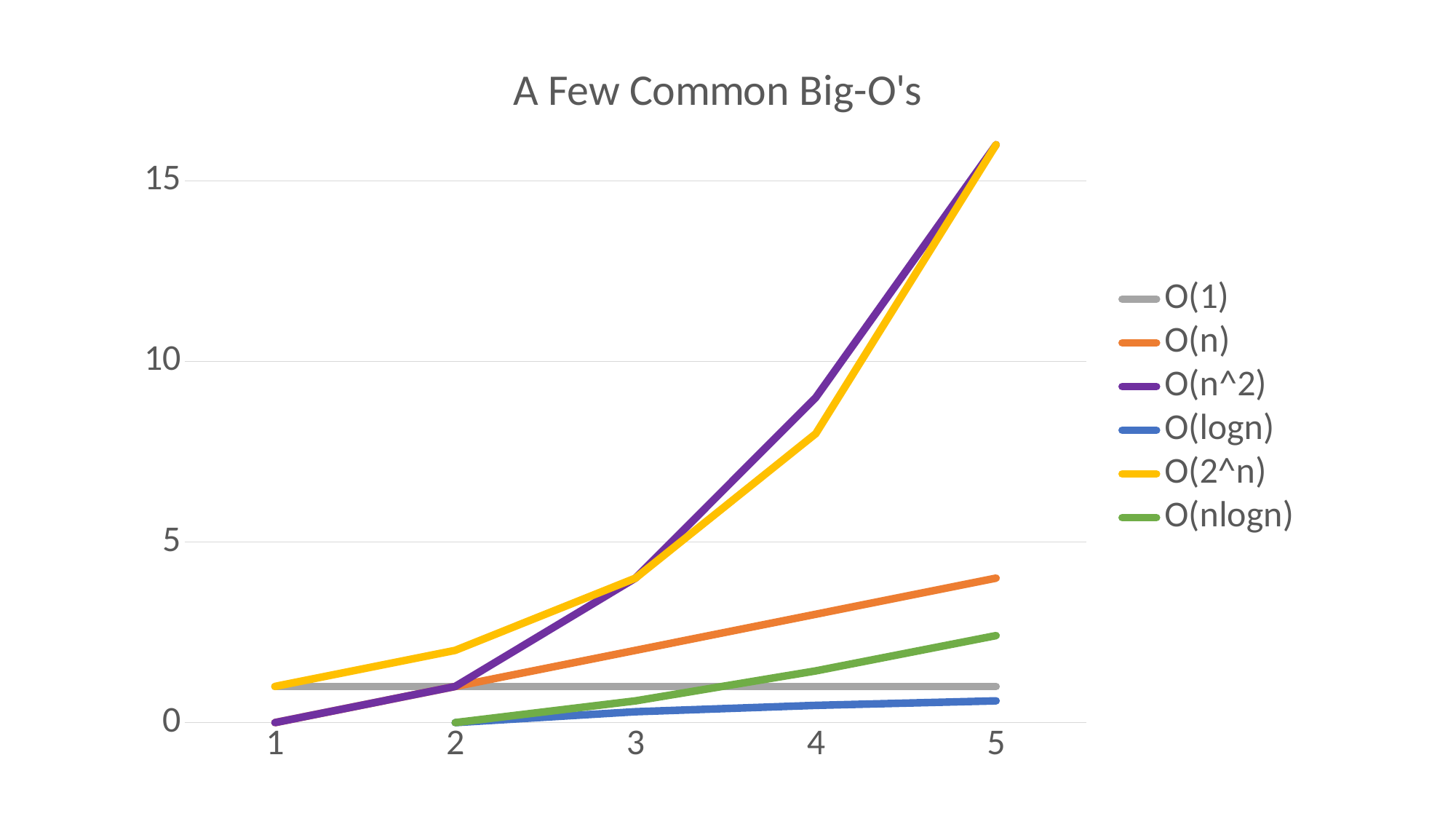
Is the value for O(n) at x = 5 greater or less than 5? less Is the value for O(n^2) at x = 5 greater or less than 15? greater Is the value for O(2^n) at x = 4 greater or less than 5? greater What is the title of the chart? A Few Common Big-O's Do the values for O(n) rise or fall as x increases from 2 to 5? rise Which colour is used for the O(2^n) line? yellow What type of chart is shown on the slide? line chart How many series does the legend list? 6 How many points are labelled along the x axis? 5 Which is larger at x = 5, O(n) or O(nlogn)? O(n) Which is larger at x = 4, O(n^2) or O(n)? O(n^2)